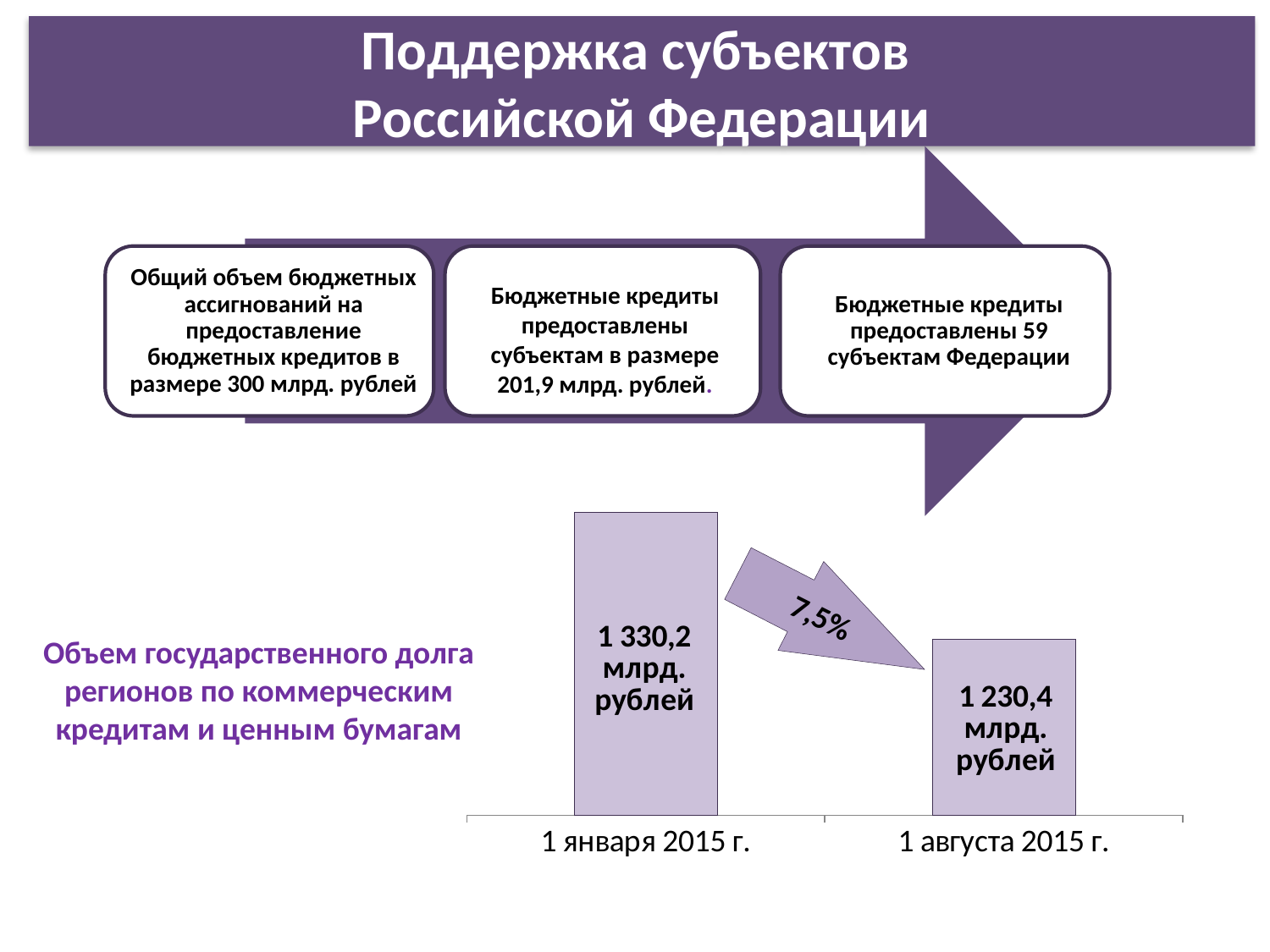
Какая дата на диаграмме имеет наименьшее значение? 1 августа 2015 г. Какое значение больше: на 1 января 2015 г. или на 1 августа 2015 г.? 1 января 2015 г. Какое значение показано на диаграмме для 1 августа 2015 г.? 1 230,4 млрд. рублей Значения на диаграмме растут или падают от 1 января 2015 г. к 1 августа 2015 г.? Падают Какой процент снижения указан на стрелке между столбцами диаграммы? 7,5% На сколько значение на 1 января 2015 г. больше значения на 1 августа 2015 г.? 99,8 млрд. рублей Сколько категорий (дат) показано на диаграмме? 2 Какая дата на диаграмме имеет наибольшее значение? 1 января 2015 г. Какого типа эта диаграмма? Столбчатая (bar chart) Что показывает диаграмма согласно подписи слева от неё? Объем государственного долга регионов по коммерческим кредитам и ценным бумагам Какое значение показано на диаграмме для 1 января 2015 г.? 1 330,2 млрд. рублей